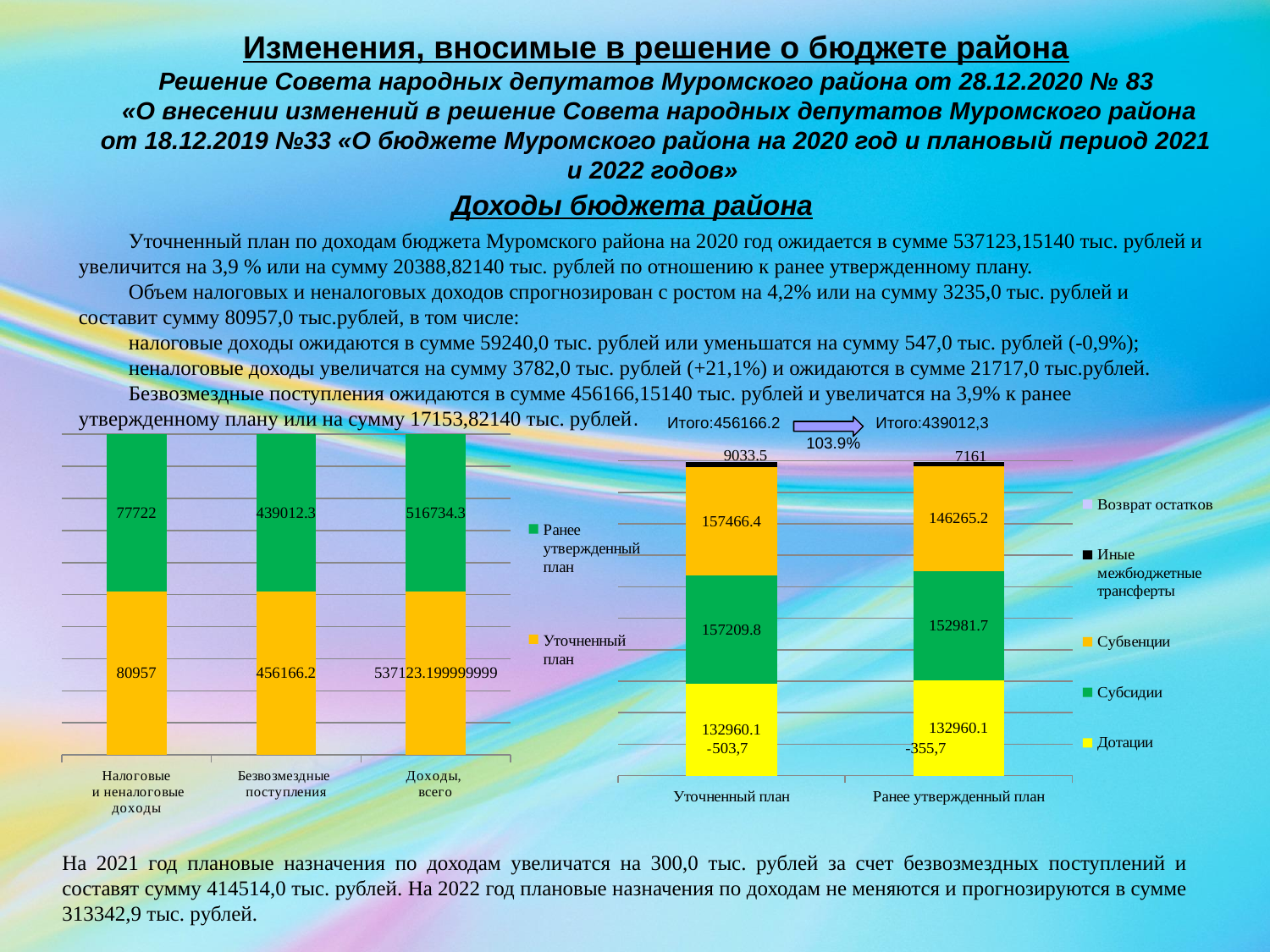
In the left chart, how many categories are shown on the x axis? 3 In the left chart, what is the value of the 'Ранее утвержденный план' series for 'Налоговые и неналоговые доходы'? 77722 In the left chart, what is the value of the 'Уточненный план' series for 'Безвозмездные поступления'? 456166.2 In the right chart, what is the 'Субсидии' value for 'Уточненный план'? 157209.8 In the left chart, what is the value of the 'Ранее утвержденный план' series for 'Доходы, всего'? 516734.3 In the right chart, which is larger: the 'Субсидии' value for 'Уточненный план' or for 'Ранее утвержденный план'? Уточненный план In the left chart, which category has the lowest 'Уточненный план' value? Налоговые и неналоговые доходы In the right chart, how many series does the legend list? 5 In the right chart, what is the difference between the 'Субвенции' values for 'Уточненный план' and 'Ранее утвержденный план'? 11201.2 In the left chart, what is the difference between the 'Уточненный план' and 'Ранее утвержденный план' values for 'Налоговые и неналоговые доходы'? 3235 What type of chart is the left chart? Stacked bar chart In the right chart, what is the 'Субвенции' value for 'Ранее утвержденный план'? 146265.2